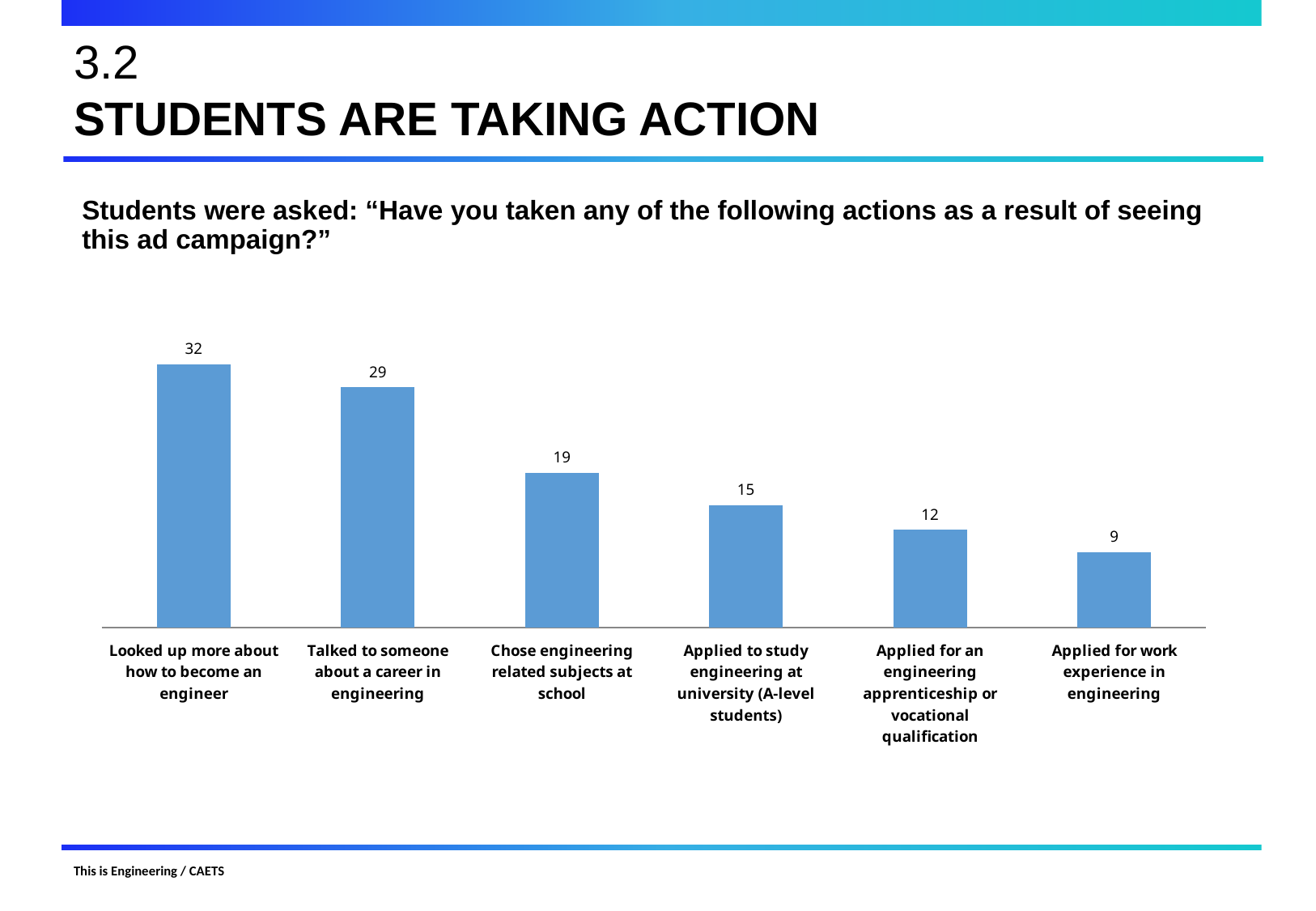
What is the value for "Applied to study engineering at university (A-level students)"? 15 Which category has the highest value? Looked up more about how to become an engineer How many categories are shown on the chart? 6 What is the difference between the highest and lowest values on the chart? 23 Which is larger: "Applied for an engineering apprenticeship or vocational qualification" or "Applied to study engineering at university (A-level students)"? Applied to study engineering at university (A-level students) What is the value for "Chose engineering related subjects at school"? 19 Do the values rise or fall from left to right across the chart? Fall What is the value for "Looked up more about how to become an engineer"? 32 What kind of chart is shown on the slide? Bar chart What is the value for "Applied for work experience in engineering"? 9 What is the difference between "Talked to someone about a career in engineering" and "Chose engineering related subjects at school"? 10 Which category has the lowest value? Applied for work experience in engineering